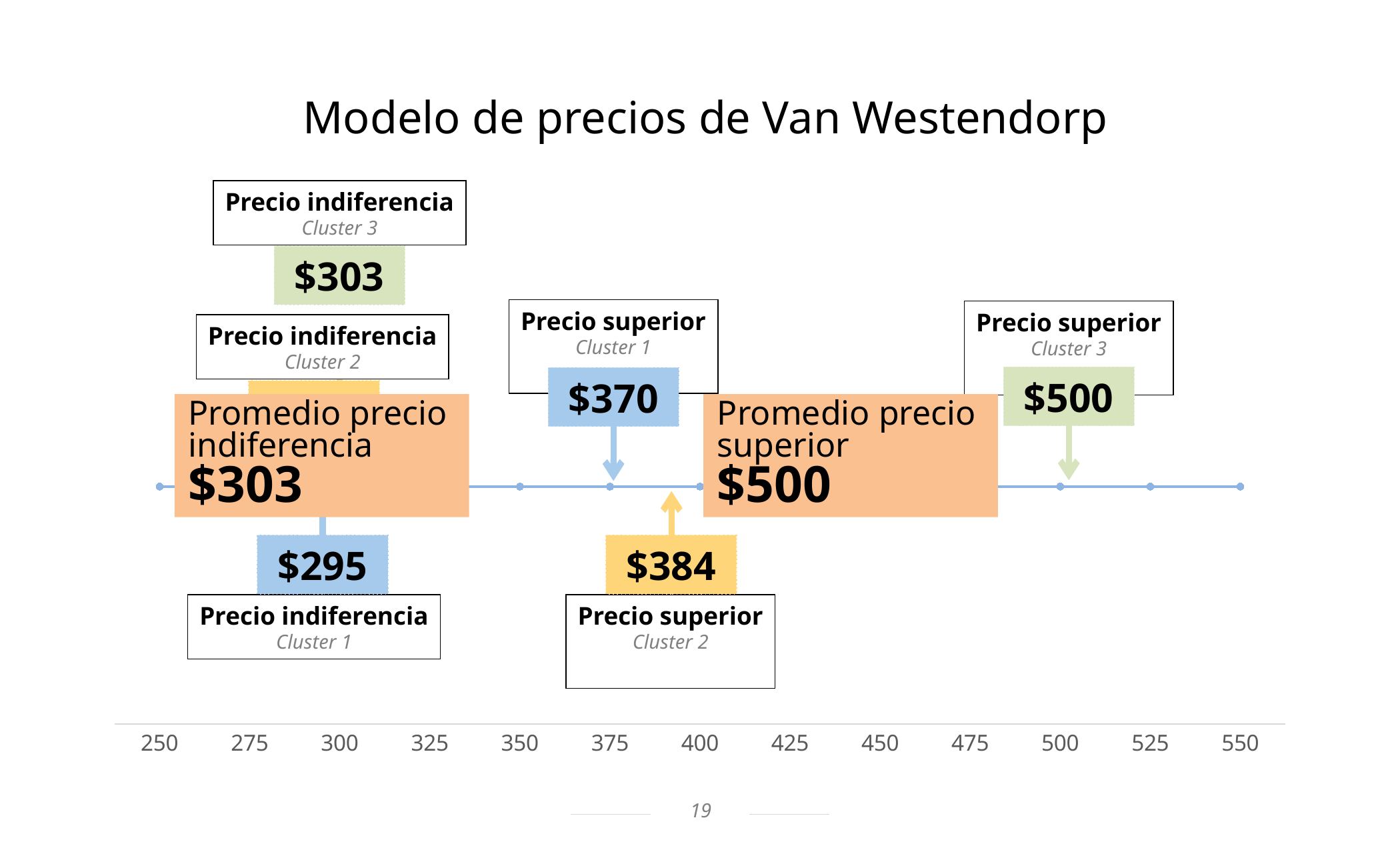
What is the Precio superior for Cluster 2? $384 What is the Promedio precio indiferencia shown on the chart? $303 Which cluster has the lowest Precio superior? Cluster 1 What is the Promedio precio superior shown on the chart? $500 Which cluster has the highest Precio superior? Cluster 3 What is the Precio indiferencia for Cluster 3? $303 What is the title of the chart? Modelo de precios de Van Westendorp Which is larger, the Precio indiferencia for Cluster 3 or for Cluster 1? Cluster 3 What is the Precio superior for Cluster 1? $370 What is the Precio superior for Cluster 3? $500 What is the difference between the Precio superior for Cluster 2 and Cluster 1? $14 What is the Precio indiferencia for Cluster 1? $295